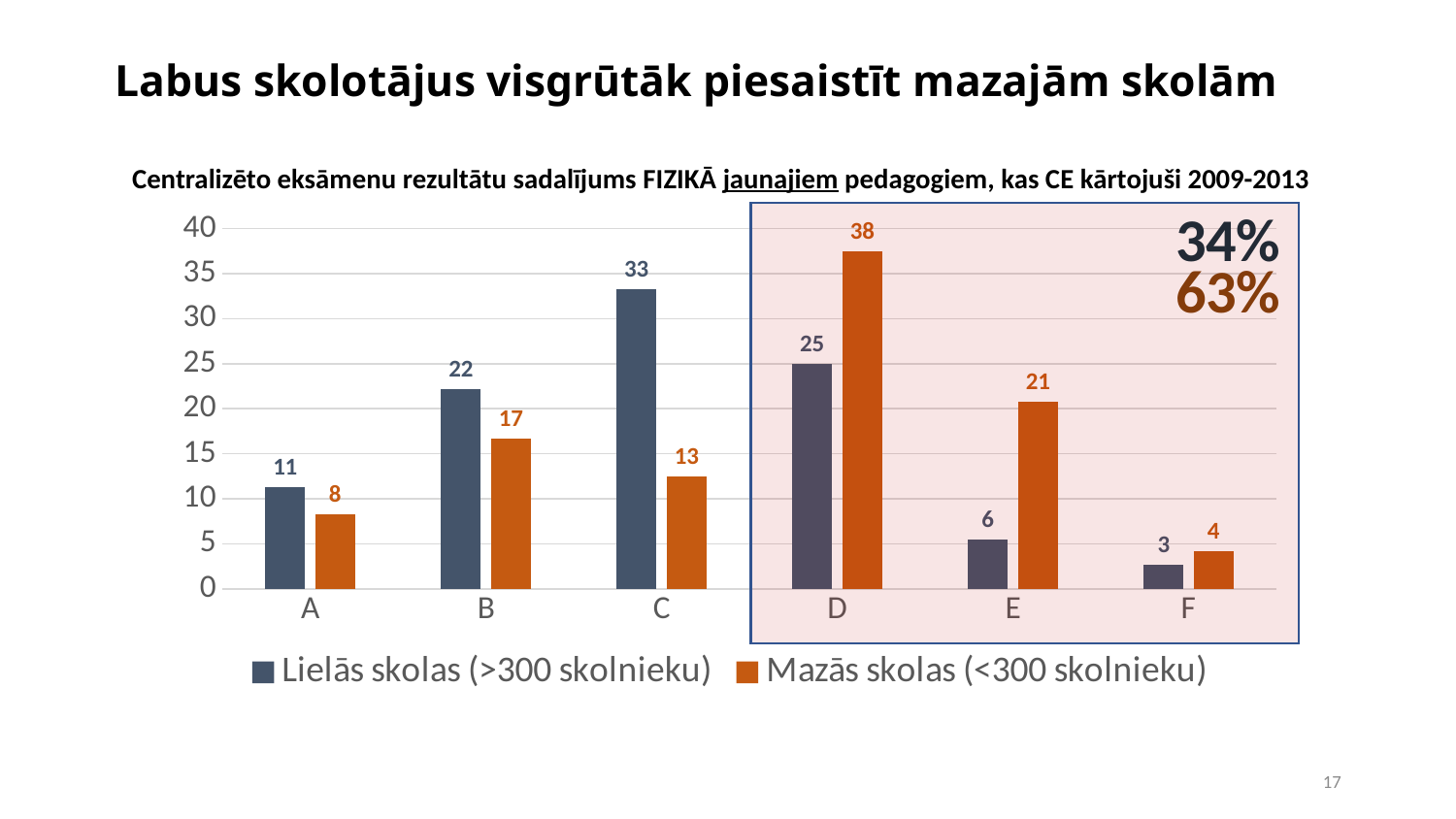
At category B, which series has the larger value: Lielās skolas (>300 skolnieku) or Mazās skolas (<300 skolnieku)? Lielās skolas (>300 skolnieku) What kind of chart is shown on the slide? bar chart What is the value for Lielās skolas (>300 skolnieku) at category C? 33 What percentage is shown in the highlighted box in the dark colour of the Lielās skolas series? 34% Which category has the lowest value for Lielās skolas (>300 skolnieku)? F How many categories are shown on the x axis? 6 What is the value for Mazās skolas (<300 skolnieku) at category D? 38 How many series does the legend list? 2 What is the difference between the Lielās skolas and Mazās skolas values at category C? 20 Which category has the highest value for Mazās skolas (<300 skolnieku)? D What is the difference between the Mazās skolas values at categories D and E? 17 What is the value for Lielās skolas (>300 skolnieku) at category E? 6